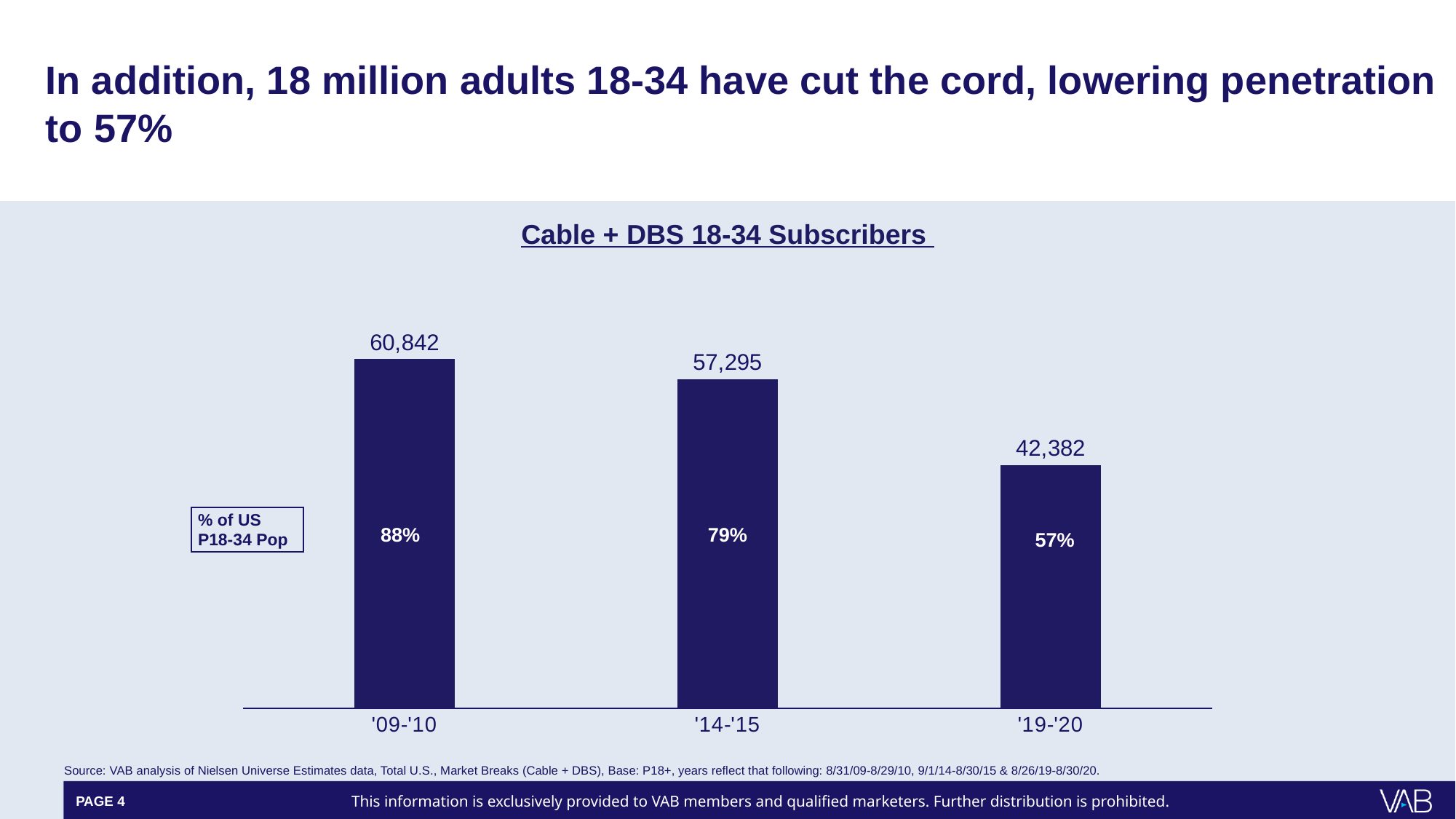
What is the difference in subscribers between '09-'10 and '19-'20? 18,460 Do the subscriber values rise or fall from '09-'10 to '19-'20? Fall What kind of chart is shown on the slide? Bar chart What is the value for '19-'20 in the Cable + DBS 18-34 Subscribers chart? 42,382 Which period has the lowest number of Cable + DBS 18-34 subscribers? '19-'20 What is the value for '09-'10 in the Cable + DBS 18-34 Subscribers chart? 60,842 What percentage of the US P18-34 population is shown inside the '09-'10 bar? 88% Which period has the highest number of Cable + DBS 18-34 subscribers? '09-'10 What percentage of the US P18-34 population is shown inside the '19-'20 bar? 57% How many periods are shown on the x axis of the chart? 3 What is the value for '14-'15 in the Cable + DBS 18-34 Subscribers chart? 57,295 Which is larger, the subscriber value for '14-'15 or for '19-'20? '14-'15